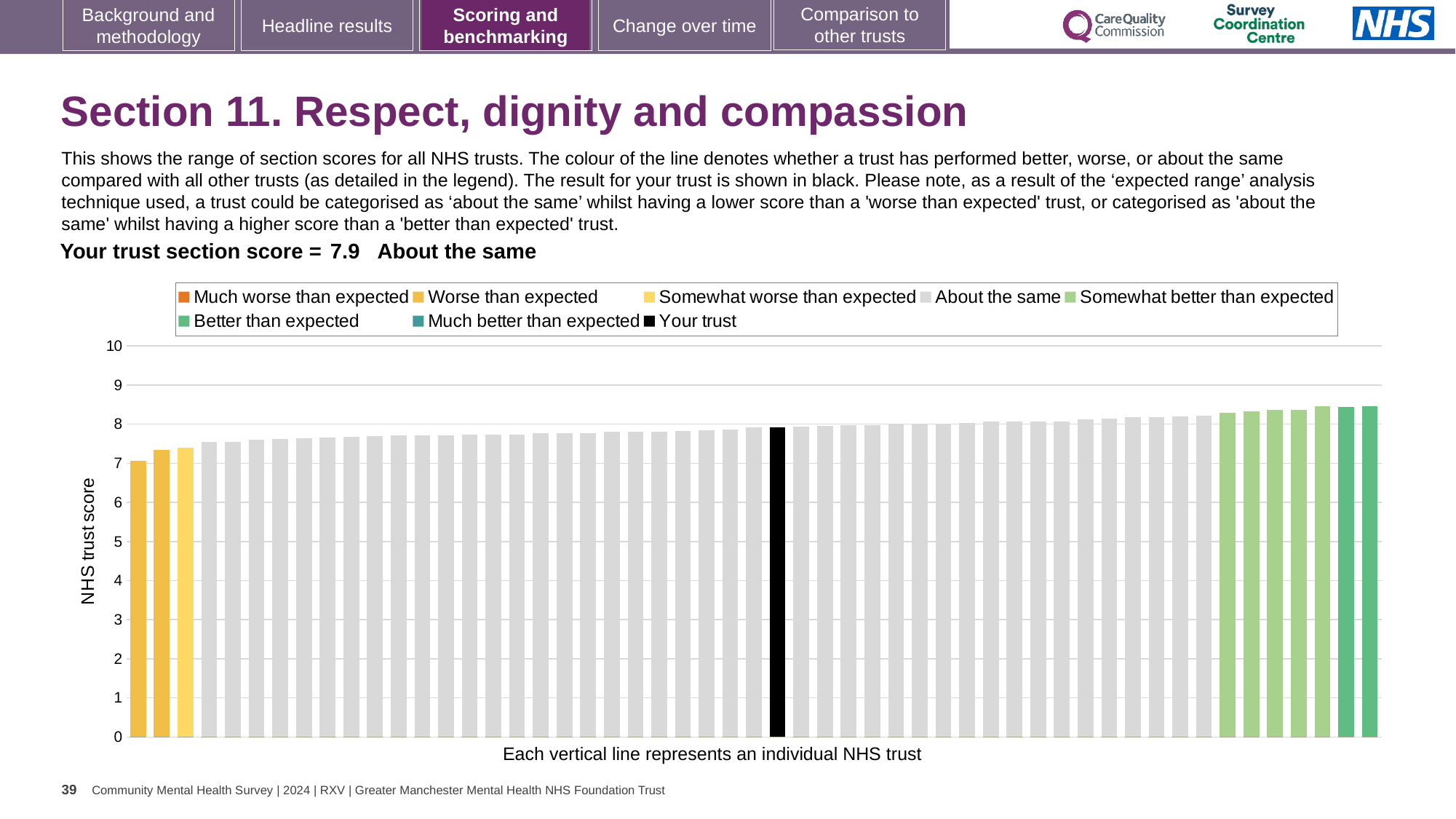
Is the value of the leftmost bar greater or less than 6? greater How many entries does the chart legend list? 8 What is the section score for your trust shown on the slide? 7.9 What is the highest value shown on the y axis? 10 Is the value of the leftmost bar greater or less than 8? less Do the bar values rise or fall from left to right along the x axis? rise What kind of chart is shown on the slide? bar chart Which performance category is your trust placed in for this section? About the same Is the value of the rightmost bar greater or less than 8? greater